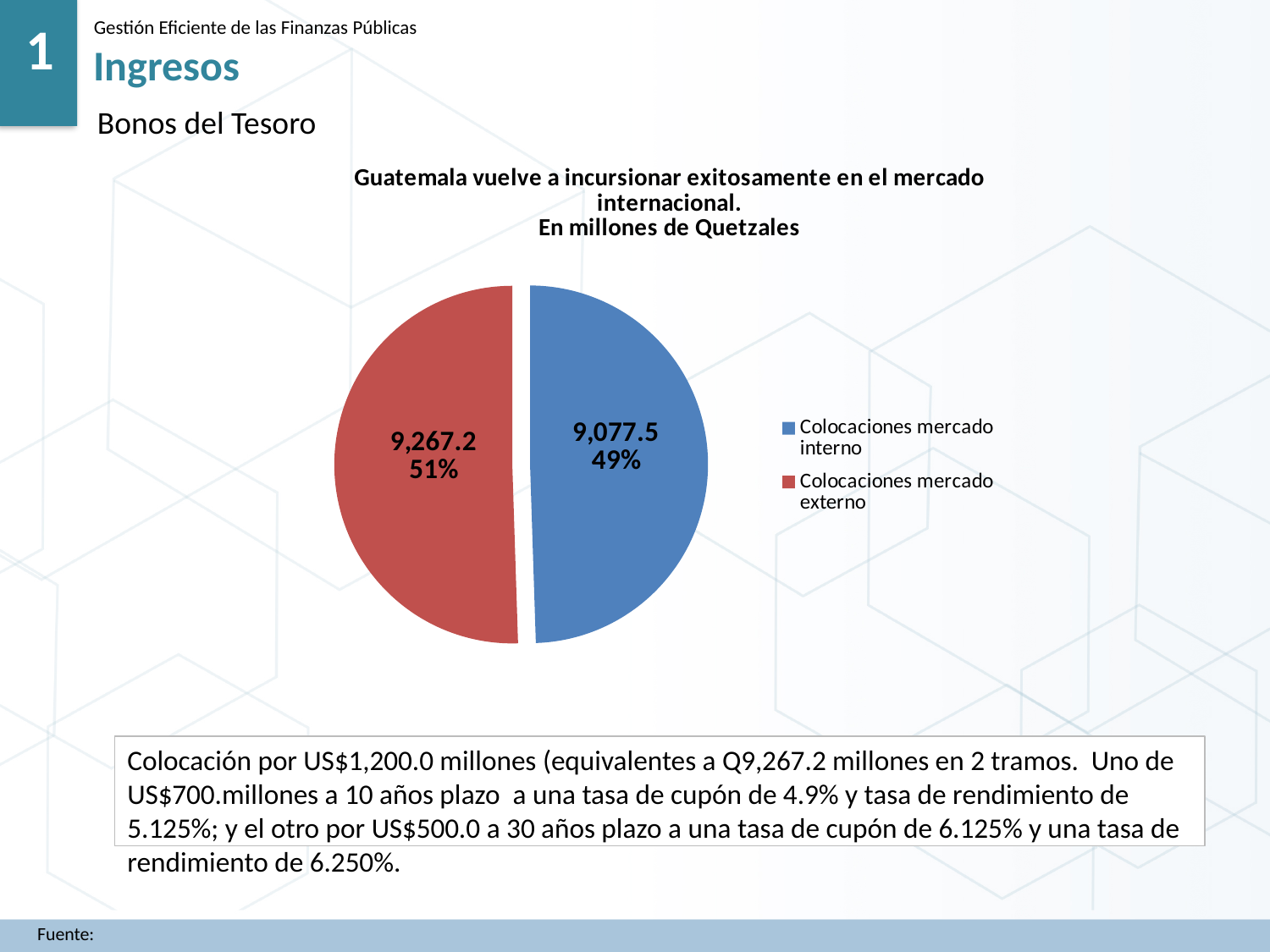
What is the value for Colocaciones mercado externo? 9,267.2 Which category has the smallest slice of the pie? Colocaciones mercado interno In what units are the chart values expressed, according to the chart title? Millones de Quetzales What colour is the slice for Colocaciones mercado externo? Red What is the difference between the values for Colocaciones mercado externo and Colocaciones mercado interno? 189.7 How many slices does the pie chart have? 2 What is the value for Colocaciones mercado interno? 9,077.5 What share of the pie does Colocaciones mercado interno represent? 49% Which category has the larger value, Colocaciones mercado interno or Colocaciones mercado externo? Colocaciones mercado externo What type of chart is shown on the slide? Pie chart How many entries does the legend list? 2 What share of the pie does Colocaciones mercado externo represent? 51%